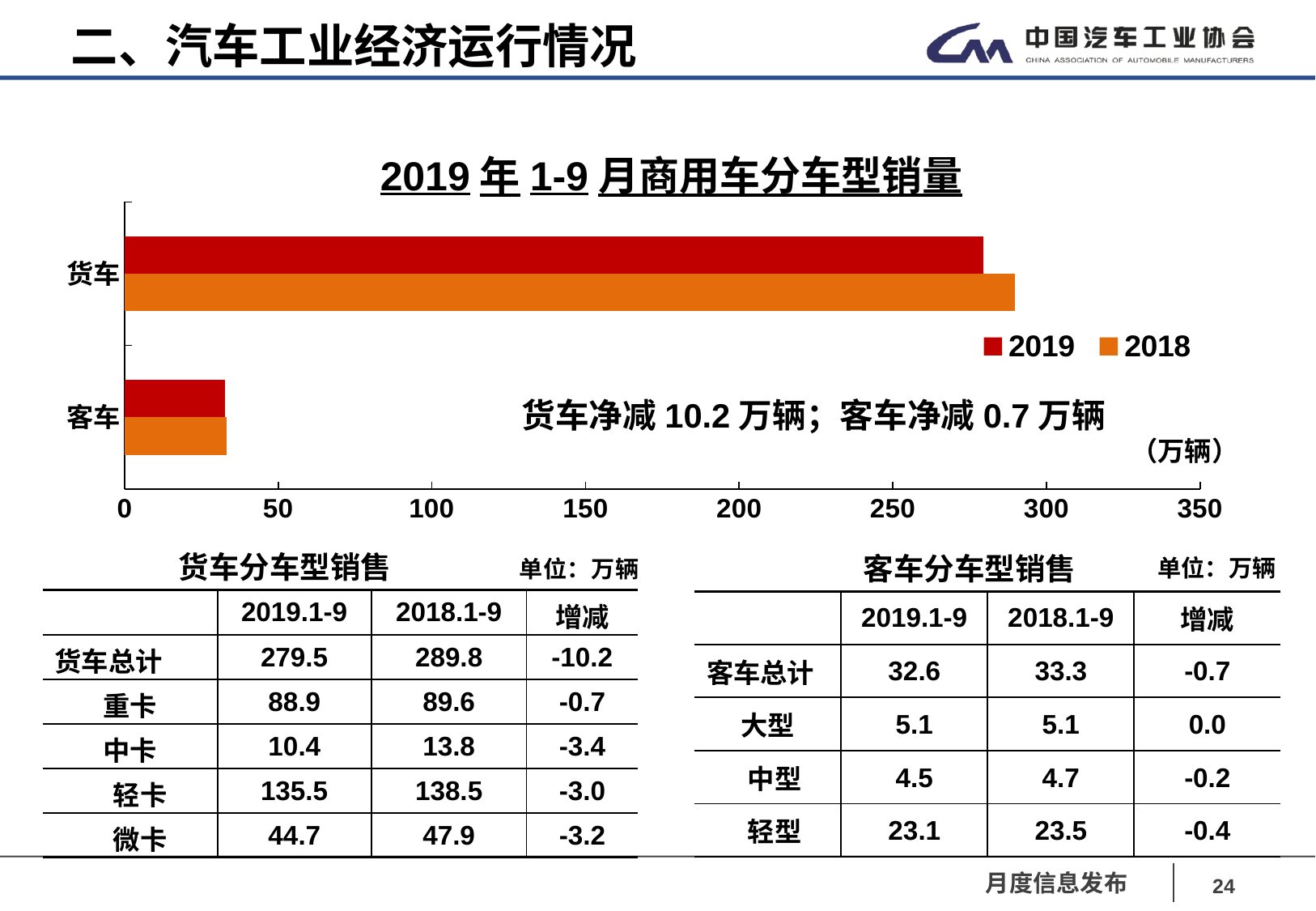
Which category has the lowest 2018 value in the chart? 客车 How many series does the chart legend list? 2 How many vehicle categories are plotted in the chart? 2 According to the slide, what is the 2018 1-9 month sales value for 客车 (in 万辆)? 33.3 What kind of chart is shown on the slide? bar chart Which colour represents the 2019 series in the chart? red Which category has the highest 2019 value in the chart? 货车 By how much did 货车 sales decrease from 2018 to 2019 according to the slide? 10.2 万辆 For 货车, which is larger: the 2019 bar or the 2018 bar? 2018 According to the slide, what is the 2019 1-9 month sales value for 货车 (in 万辆)? 279.5 Is the 2018 value for 客车 greater or less than 50? less Is the 2019 value for 货车 greater or less than 250? greater